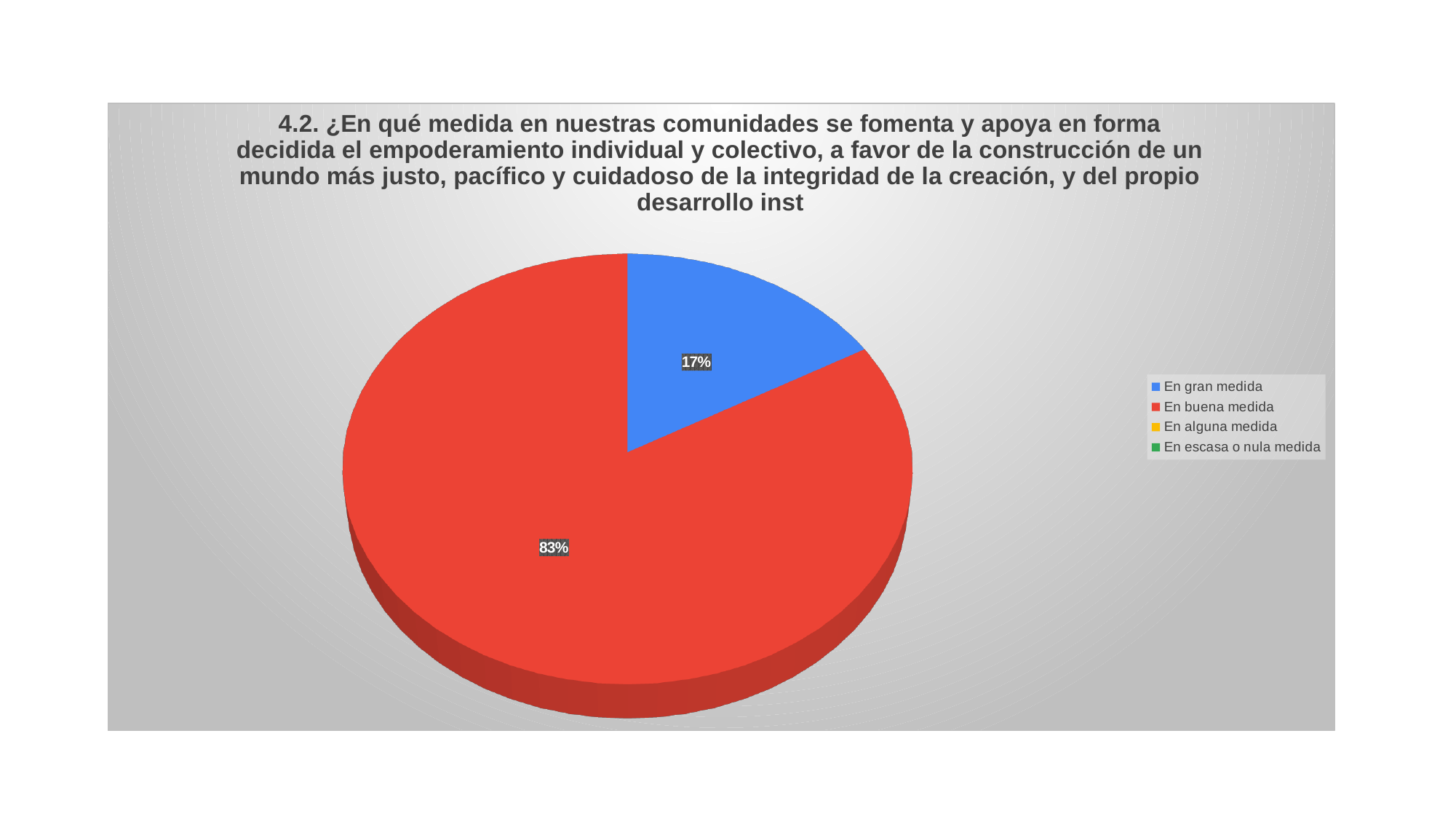
What is the difference in percentage points between the "En buena medida" and "En gran medida" slices? 66 Which of the two visible slices is larger, "En gran medida" or "En buena medida"? En buena medida Which category has the largest slice of the pie? En buena medida What kind of chart is shown on the slide? pie chart What share of the pie does "En gran medida" represent? 17% How many categories does the legend list? 4 How many slices are visible in the pie? 2 Which legend entry is shown in green? En escasa o nula medida What colour is the "En gran medida" slice? blue What share of the pie does "En buena medida" represent? 83%